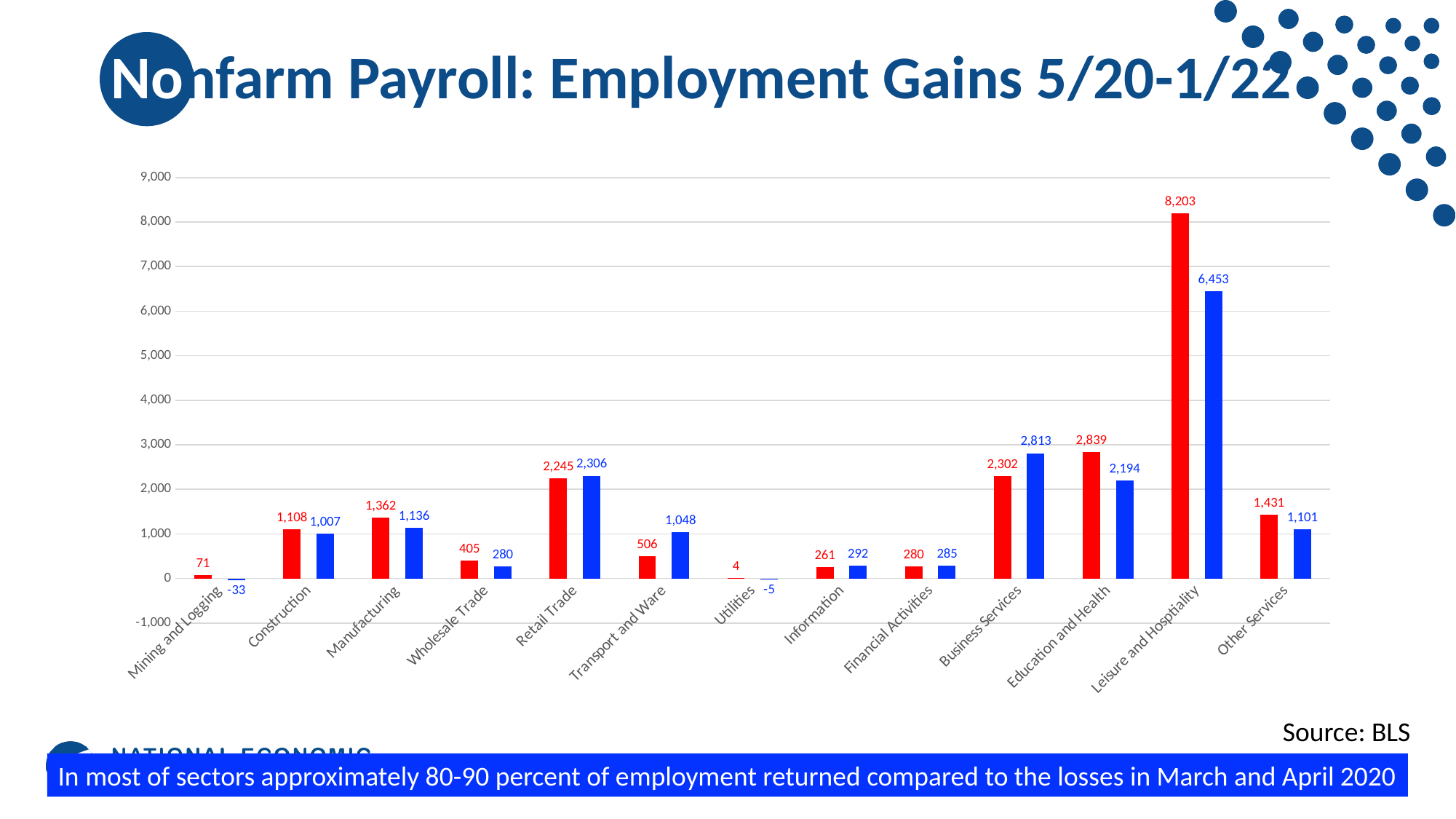
What is the title of the chart on the slide? Nonfarm Payroll: Employment Gains 5/20-1/22 What is the difference between the red bar and the blue bar for Leisure and Hospitality? 1,750 How many categories are shown on the x axis? 13 What is the value of the blue bar for Mining and Logging? -33 Which category has the highest red bar? Leisure and Hospitality Is the value of the blue bar for Leisure and Hospitality greater or less than 6,000? greater What is the value of the red bar for Education and Health? 2,839 Which is larger for Business Services, the red bar or the blue bar? the blue bar What kind of chart is shown on the slide? bar chart What is the value of the blue bar for Transport and Ware? 1,048 What is the value of the red bar for Leisure and Hospitality? 8,203 Which category has the lowest blue bar? Mining and Logging